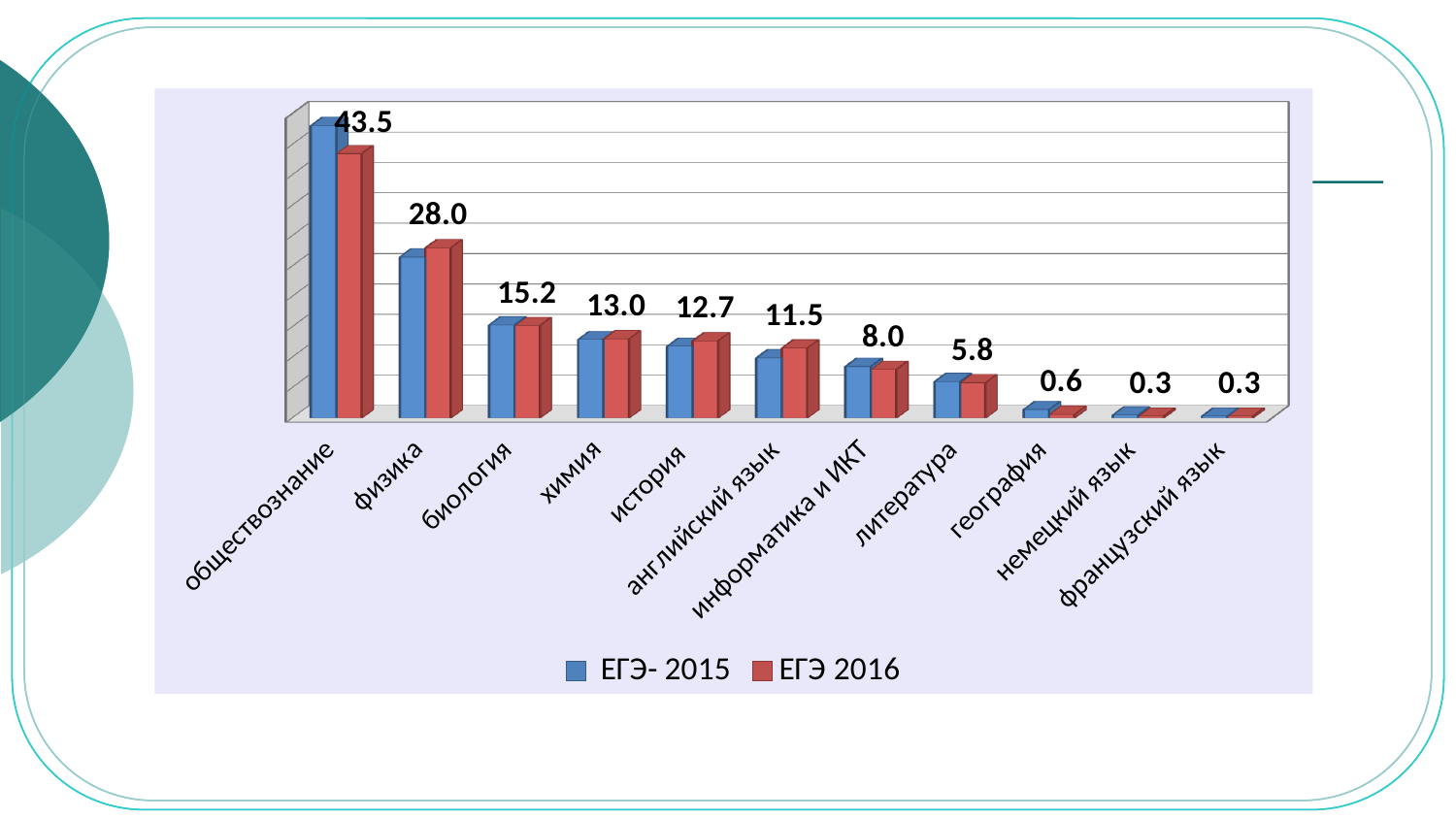
What data label is printed above the bars for биология? 15.2 Do the bar heights generally rise or fall moving from left to right along the x axis? fall What data label is printed above the bars for география? 0.6 How many subject categories are shown on the x axis? 11 Which subject has the highest bars in the chart? обществознание For физика, which series has the taller bar, ЕГЭ- 2015 or ЕГЭ 2016? ЕГЭ 2016 What kind of chart is shown on the slide? bar chart For обществознание, which series has the taller bar, ЕГЭ- 2015 or ЕГЭ 2016? ЕГЭ- 2015 What data label is printed above the bars for физика? 28.0 How many series does the legend list? 2 What data label is printed above the bars for информатика и ИКТ? 8.0 What colour are the bars for the ЕГЭ 2016 series? red